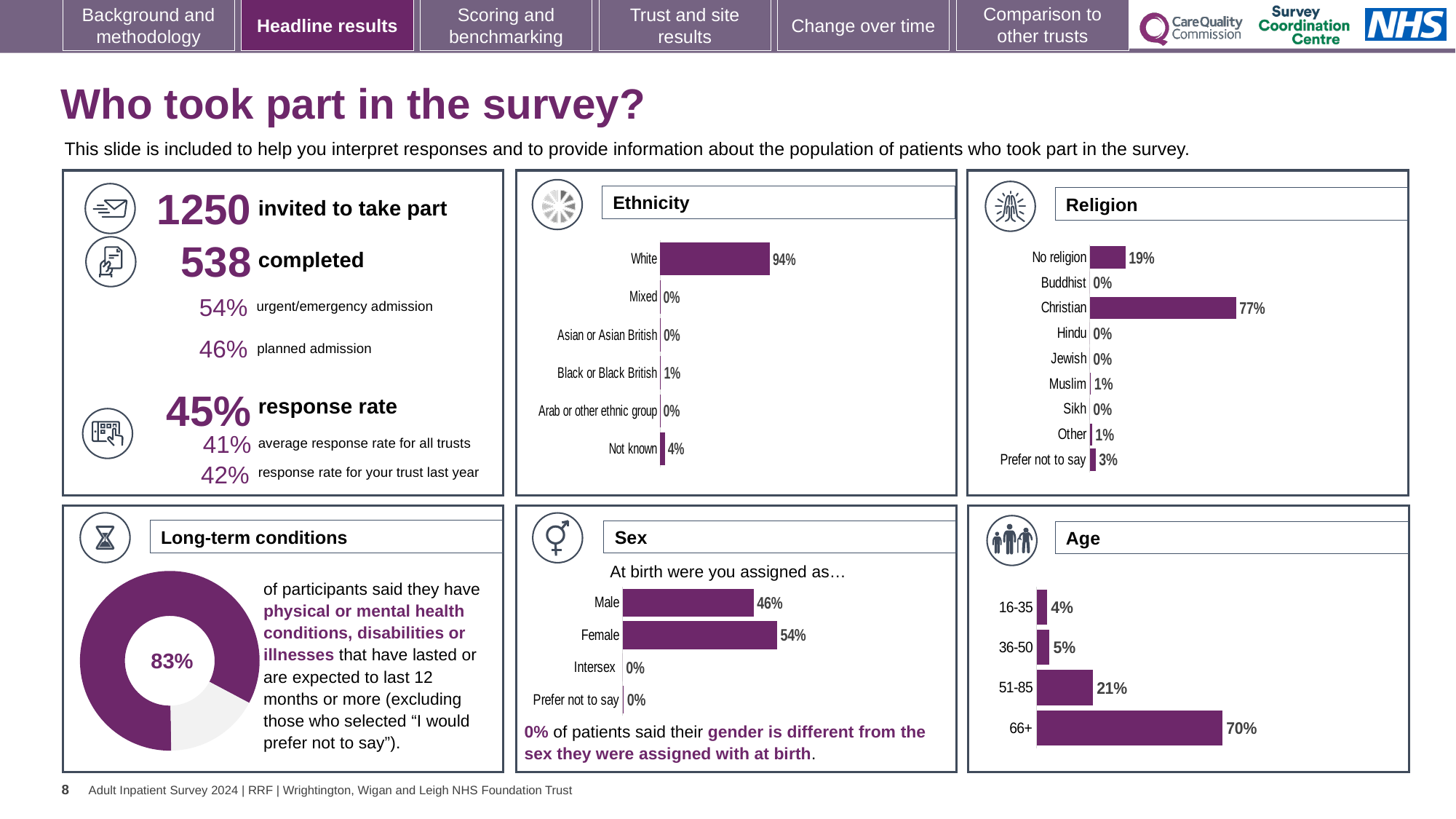
In the Religion chart, what is the difference between Christian and No religion? 58% In the Religion chart, what percentage of respondents are Christian? 77% In the Ethnicity chart, which category has the highest value? White In the Religion chart, how many categories are shown? 9 In the Ethnicity chart, what is the value for Not known? 4% In the Sex chart, what is the difference between Female and Male? 8% In the Age chart, which age group has the highest value? 66+ In the Age chart, what is the value for 51-85? 21% What kind of chart is the Long-term conditions chart? doughnut chart In the Ethnicity chart, what percentage of respondents are White? 94% In the Sex chart, which is larger, Male or Female? Female In the Age chart, do the values rise or fall as age increases along the categories? rise